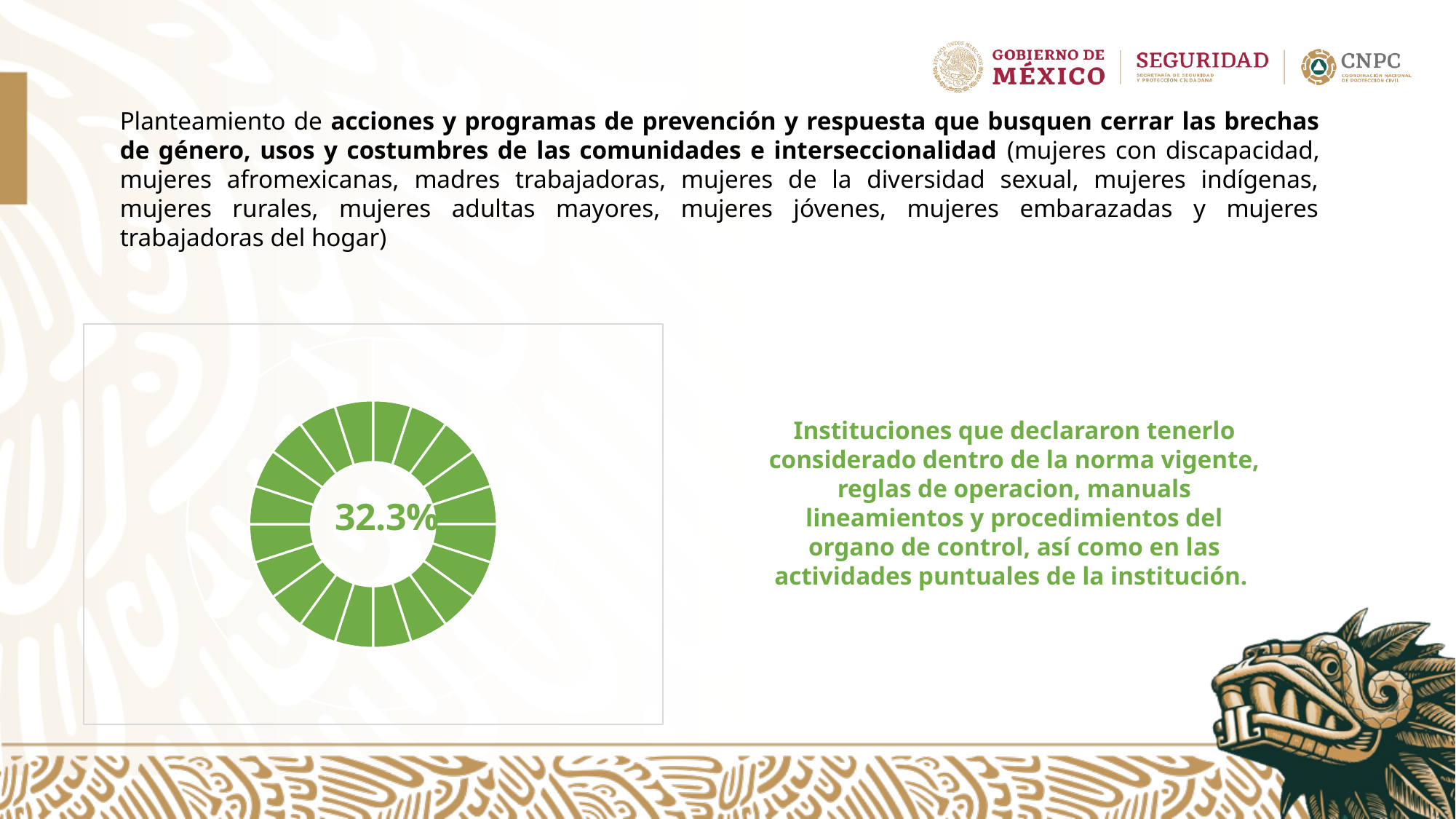
What percentage is displayed in the centre of the doughnut chart? 32.3% What colour are the segments of the doughnut chart? Green Is the value shown in the doughnut chart greater or less than 30%? greater Is the value shown in the doughnut chart greater or less than 50%? less What kind of chart is shown on the left of the slide? Doughnut chart